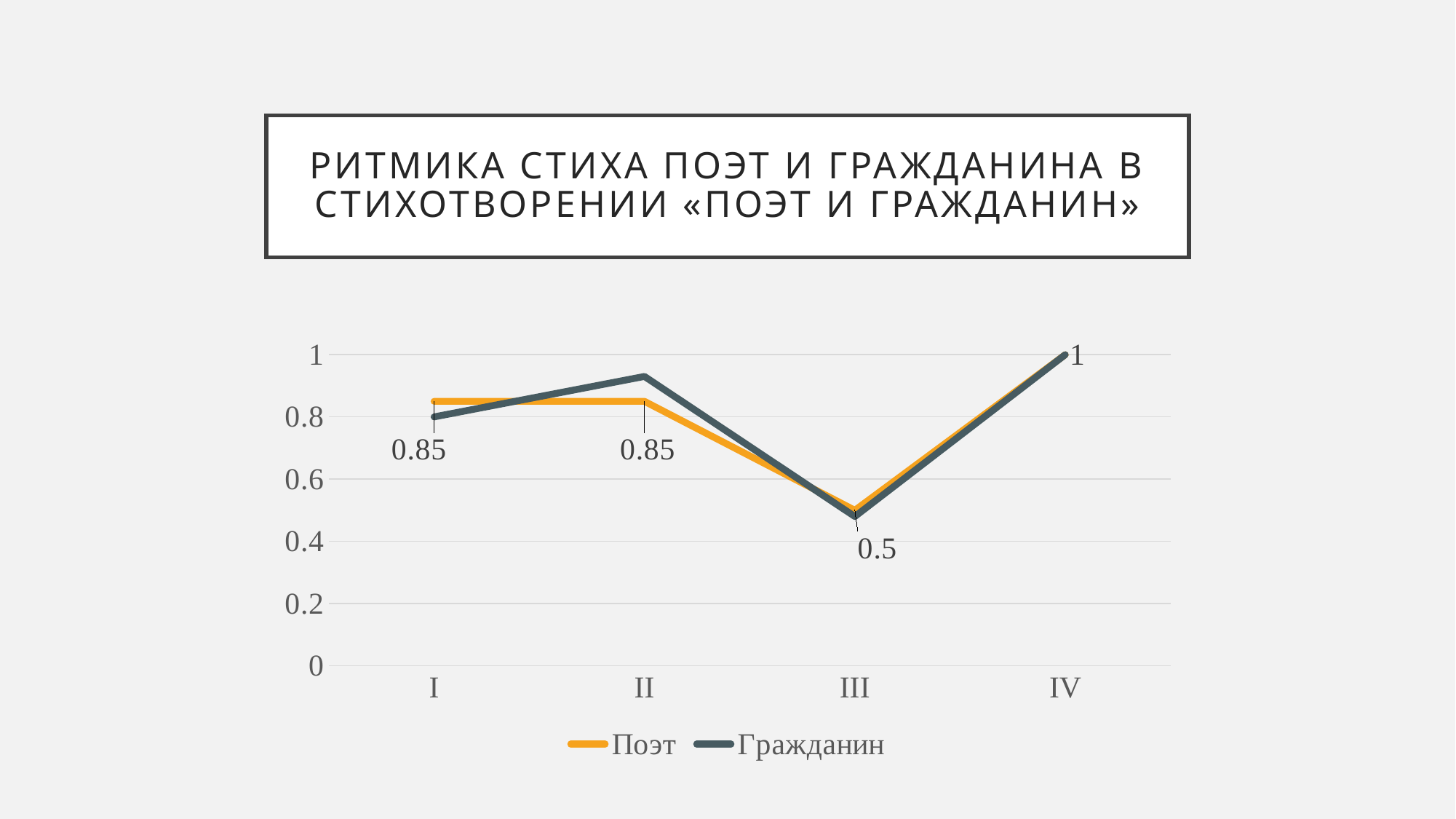
How many series does the legend list? 2 Is the value for Гражданин at category III greater or less than 0.6? less What is the difference between the Поэт values at category I and category III? 0.35 What is the value for Поэт at category IV? 1 At which category is the Поэт series highest? IV At which category is the Поэт series lowest? III How many categories are shown on the x axis? 4 What is the value for Поэт at category III? 0.5 What kind of chart is shown on the slide? line chart Which colour is used for the Поэт series in the legend? orange What is the value for Поэт at category I? 0.85 At category II, which series has the larger value, Поэт or Гражданин? Гражданин